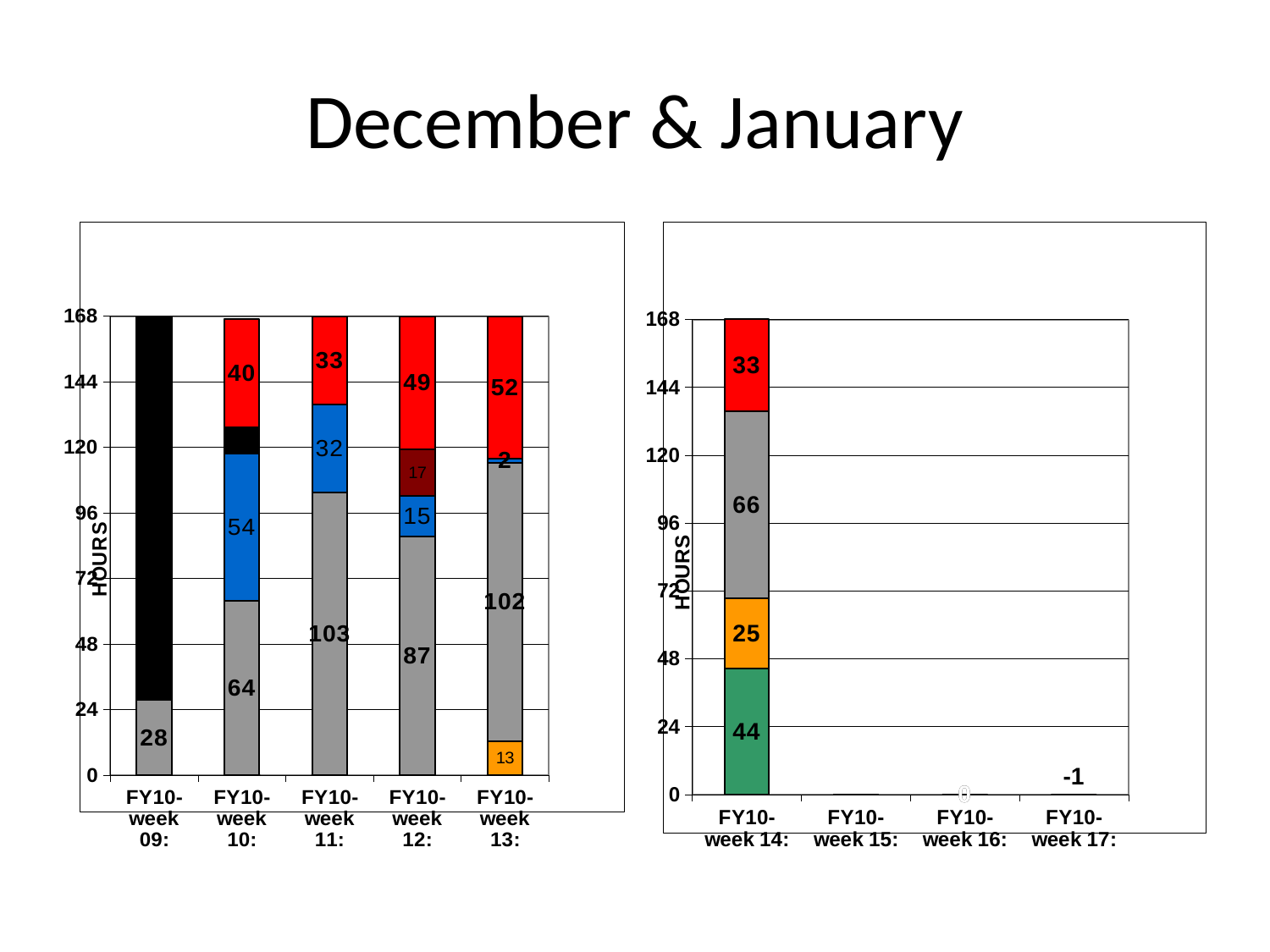
How many weeks are shown on the x axis of the right chart? 4 How many weeks are shown on the x axis of the left chart? 5 What is the y-axis title of the charts on the slide? HOURS In the left chart, which week has the smallest gray segment? FY10-week 09 In the left chart, what is the value of the gray segment for FY10-week 11? 103 In the left chart, what is the value of the red segment for FY10-week 13? 52 In the right chart, what is the total of the stacked bar for FY10-week 14? 168 What kind of chart is shown on the left of the slide? Stacked bar chart In the left chart, what is the value of the orange segment for FY10-week 13? 13 In the left chart, which is larger: the blue segment for FY10-week 10 or the blue segment for FY10-week 11? FY10-week 10 In the left chart, what is the difference between the red segment for FY10-week 12 and the red segment for FY10-week 11? 16 In the right chart, what is the value labelled for FY10-week 17? -1